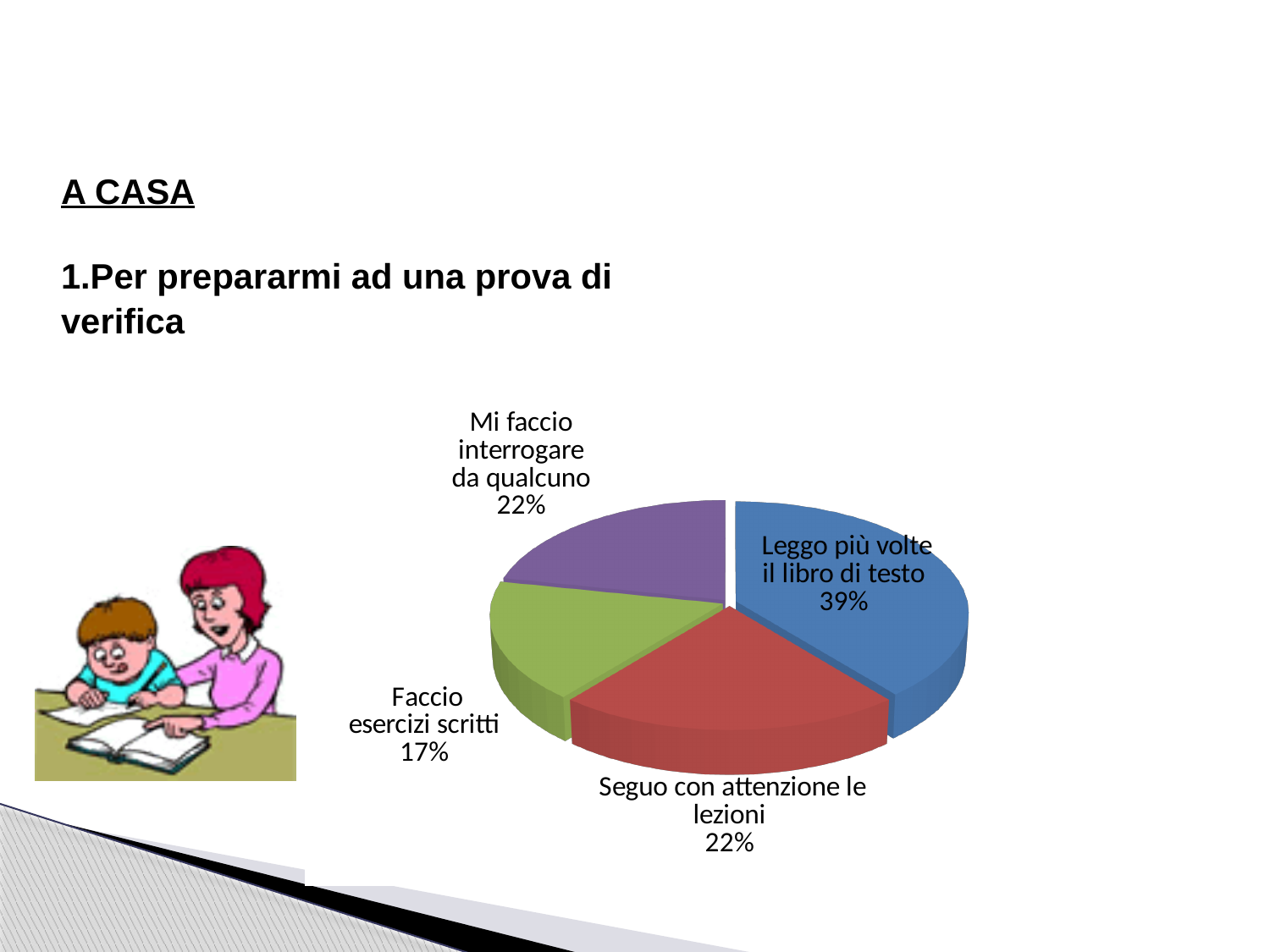
What is the difference between the shares of 'Leggo più volte il libro di testo' and 'Faccio esercizi scritti'? 22% What kind of chart is shown on the slide? pie chart What is the difference between the shares of 'Mi faccio interrogare da qualcuno' and 'Faccio esercizi scritti'? 5% Which category has the largest slice of the pie? Leggo più volte il libro di testo Which category has the smallest slice of the pie? Faccio esercizi scritti What share of the pie is 'Seguo con attenzione le lezioni'? 22% What share of the pie is 'Leggo più volte il libro di testo'? 39% What share of the pie is 'Faccio esercizi scritti'? 17% What colour is the slice for 'Seguo con attenzione le lezioni'? red Which is larger: the share for 'Leggo più volte il libro di testo' or the share for 'Seguo con attenzione le lezioni'? Leggo più volte il libro di testo How many slices does the pie chart have? 4